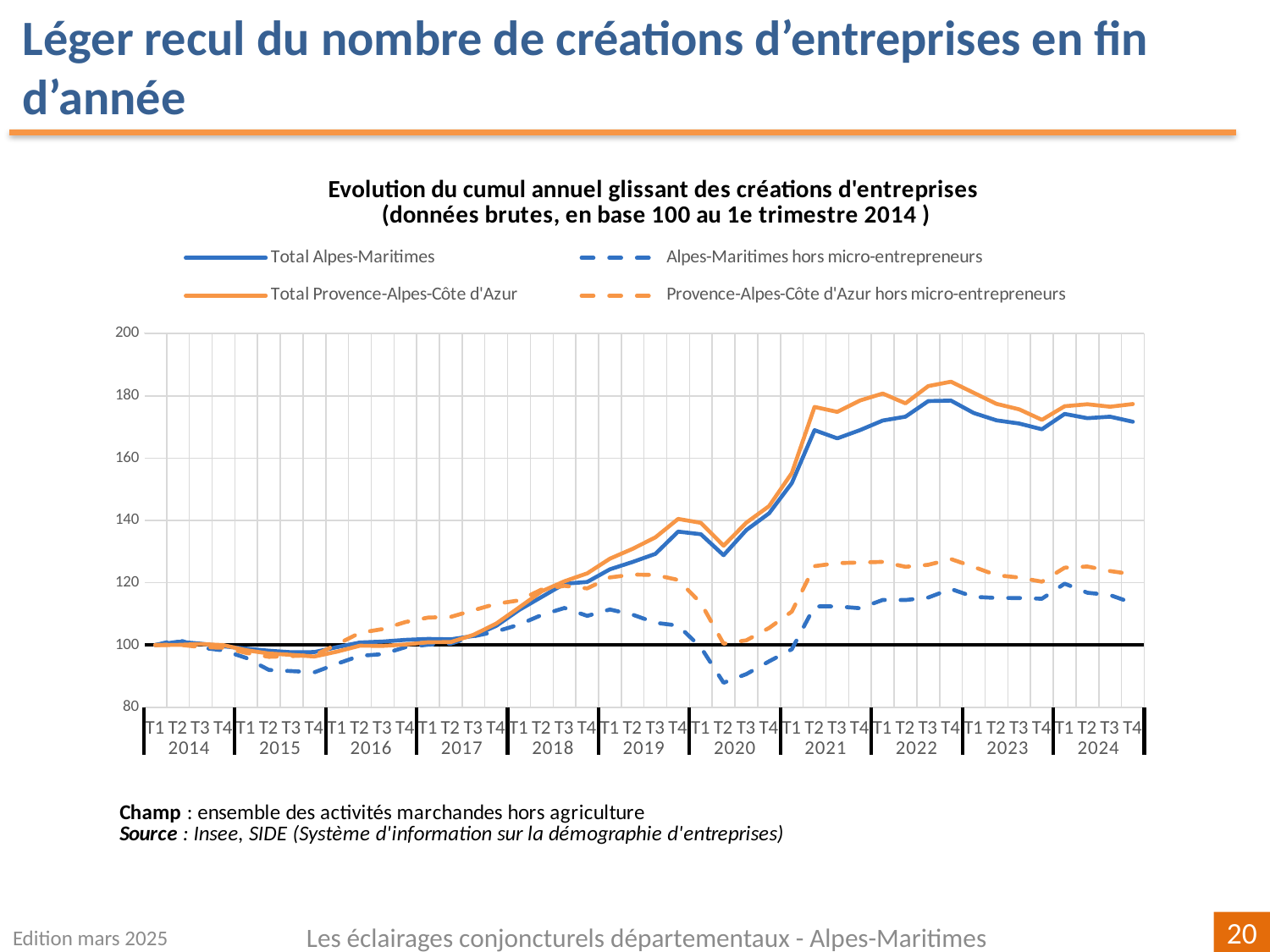
Is the value for Total Alpes-Maritimes at T1 2020 greater or less than 120? greater Is the value for Total Alpes-Maritimes at T4 2024 greater or less than 160? greater How many years are labelled along the x axis? 11 What is the base period of the index (base 100) according to the chart title? 1e trimestre 2014 Is the value for Alpes-Maritimes hors micro-entrepreneurs at T4 2024 greater or less than 120? less Does the Total Alpes-Maritimes series rise or fall overall from T1 2014 to T4 2024? rise What kind of chart is shown on the slide? line chart How many series does the legend list? 4 At T4 2024, which is higher: Provence-Alpes-Côte d'Azur hors micro-entrepreneurs or Alpes-Maritimes hors micro-entrepreneurs? Provence-Alpes-Côte d'Azur hors micro-entrepreneurs At T4 2024, which is higher: Total Provence-Alpes-Côte d'Azur or Total Alpes-Maritimes? Total Provence-Alpes-Côte d'Azur